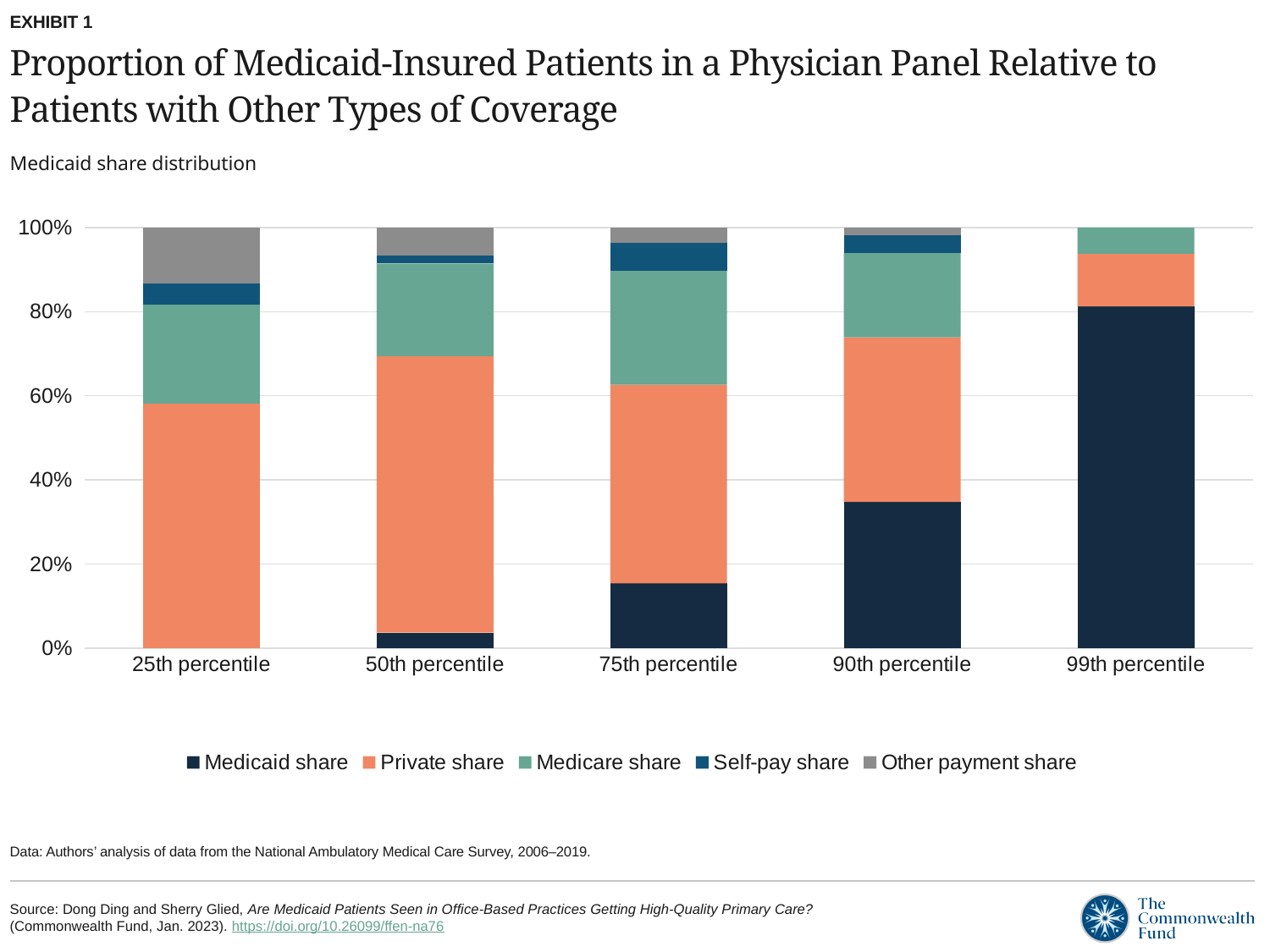
How many series does the legend list? 5 Which percentile has the smallest Medicaid share? 25th percentile Which is larger, the Private share at the 50th percentile or the Private share at the 99th percentile? 50th percentile Does the Medicaid share rise or fall moving from the 25th percentile to the 99th percentile? Rise Which series is shown in orange in the legend? Private share Is the Medicaid share at the 75th percentile greater or less than 20%? less Is the Medicaid share at the 99th percentile greater or less than 60%? greater How many percentile categories are shown on the x axis? 5 Is the Medicaid share at the 90th percentile greater or less than 40%? less Which percentile has the largest Other payment share? 25th percentile What kind of chart is shown on the slide? Stacked bar chart Which percentile has the largest Medicaid share? 99th percentile